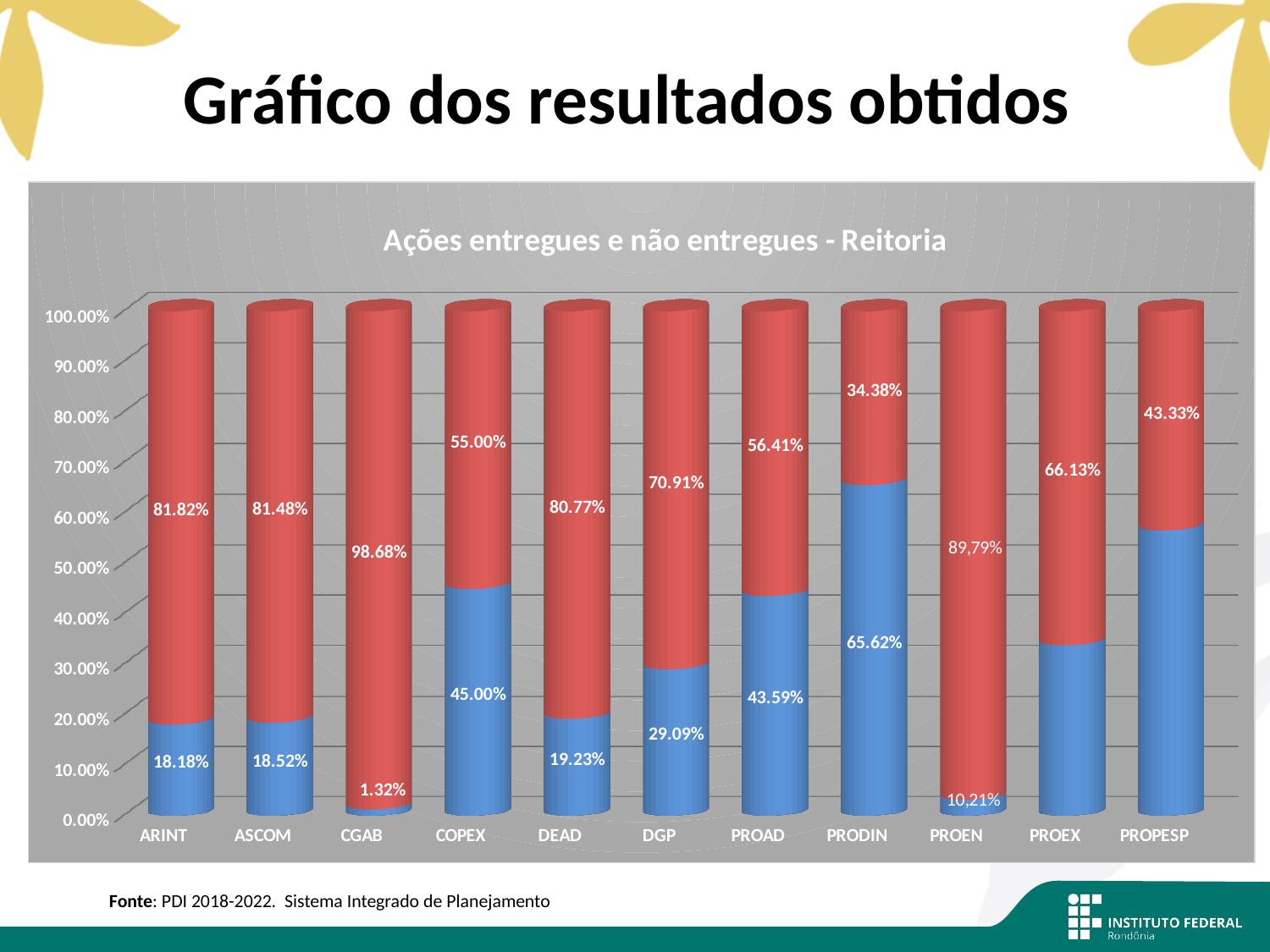
Is the blue segment for PROPESP greater or less than 50.00%? greater What is the value of the blue segment for COPEX? 45.00% What kind of chart is shown on the slide? stacked bar chart What is the value of the red segment for PROEX? 66.13% What is the value of the red segment for CGAB? 98.68% What is the difference between the red segment values of DEAD and DGP? 9.86% What is the value of the blue segment for PRODIN? 65.62% Which category has the smallest blue segment? CGAB Which has a larger blue segment, PROAD or DGP? PROAD How many categories are shown on the x axis of the chart? 11 What is the title of the chart? Ações entregues e não entregues - Reitoria Which category has the largest blue segment? PRODIN